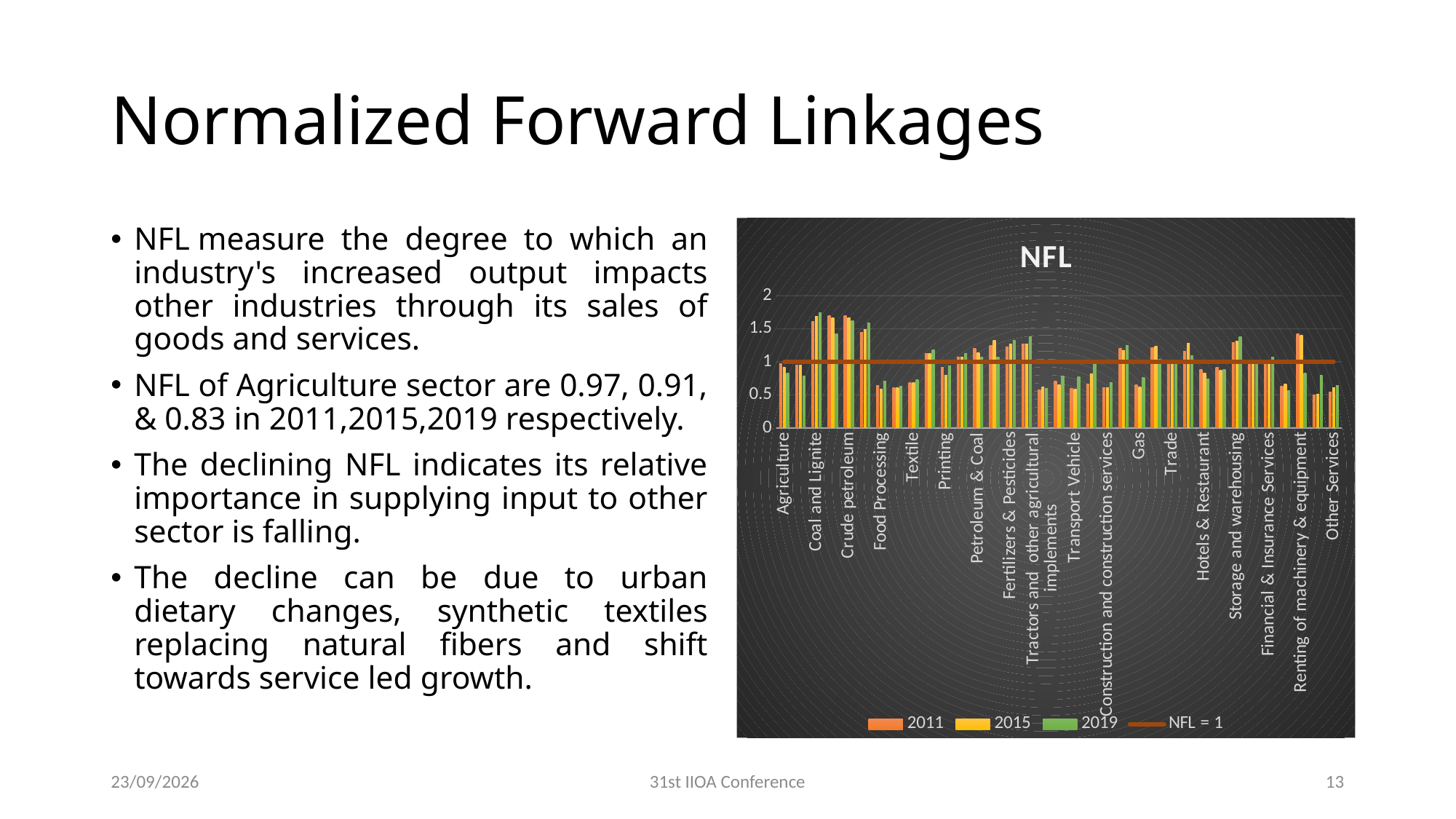
What is the difference between the Agriculture NFL values in 2011 and 2019? 0.14 What is the NFL value for Agriculture in 2015? 0.91 Which years are shown as bar series in the chart legend? 2011, 2015, 2019 Do the NFL values for Agriculture rise or fall from 2011 to 2019? fall What is the NFL value for Agriculture in 2019? 0.83 Which is larger for Agriculture, the 2011 value or the 2019 value? 2011 Is the 2019 value for Food Processing greater or less than 1? less What is the title of the chart? NFL What kind of chart is shown on the slide? bar chart What is the NFL value for Agriculture in 2011? 0.97 How many entries does the chart legend list? 4 Is the 2019 value for Coal and Lignite greater or less than 1.5? greater